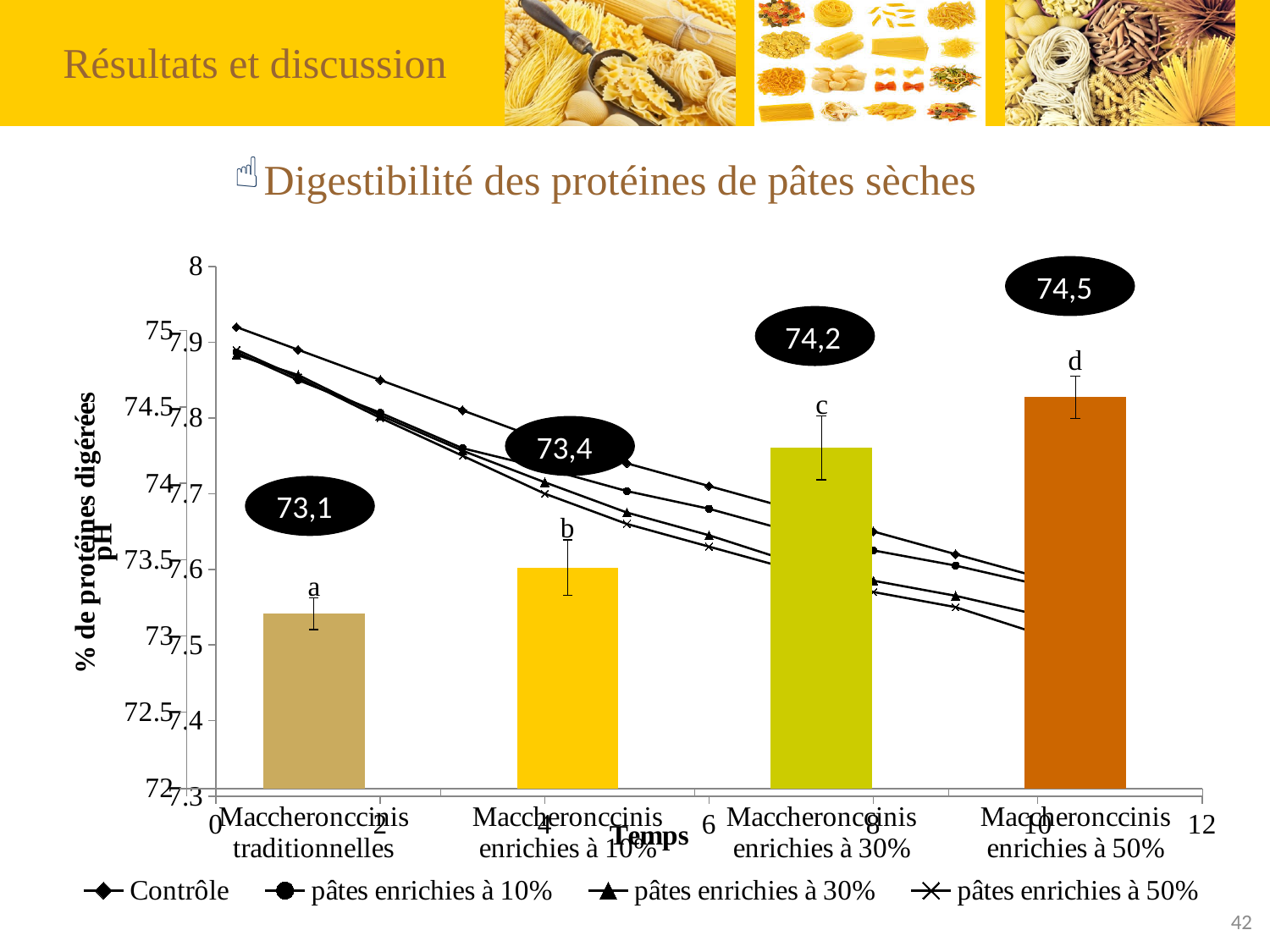
On the line chart of pH versus Temps, how many series does the legend list? 4 On the bar chart of % de protéines digérées, what is the value for Maccheronccinis enrichies à 30%? 74,2 On the bar chart of % de protéines digérées, which is larger: Maccheronccinis enrichies à 10% or Maccheronccinis enrichies à 30%? Maccheronccinis enrichies à 30% On the line chart of pH versus Temps, is the Contrôle value at Temps 0 greater or less than 7.8? greater On the line chart of pH versus Temps, is the value for pâtes enrichies à 50% at Temps 10 greater or less than 7.6? less What kind of chart shows the % de protéines digérées values? bar chart On the bar chart of % de protéines digérées, which category has the lowest value? Maccheronccinis traditionnelles On the line chart of pH versus Temps, do the values rise or fall as Temps increases? fall On the bar chart of % de protéines digérées, what is the value for Maccheronccinis traditionnelles? 73,1 On the bar chart of % de protéines digérées, what is the difference between Maccheronccinis enrichies à 50% and Maccheronccinis traditionnelles? 1,4 On the bar chart of % de protéines digérées, how many bars are plotted? 4 On the bar chart of % de protéines digérées, which category has the highest value? Maccheronccinis enrichies à 50%